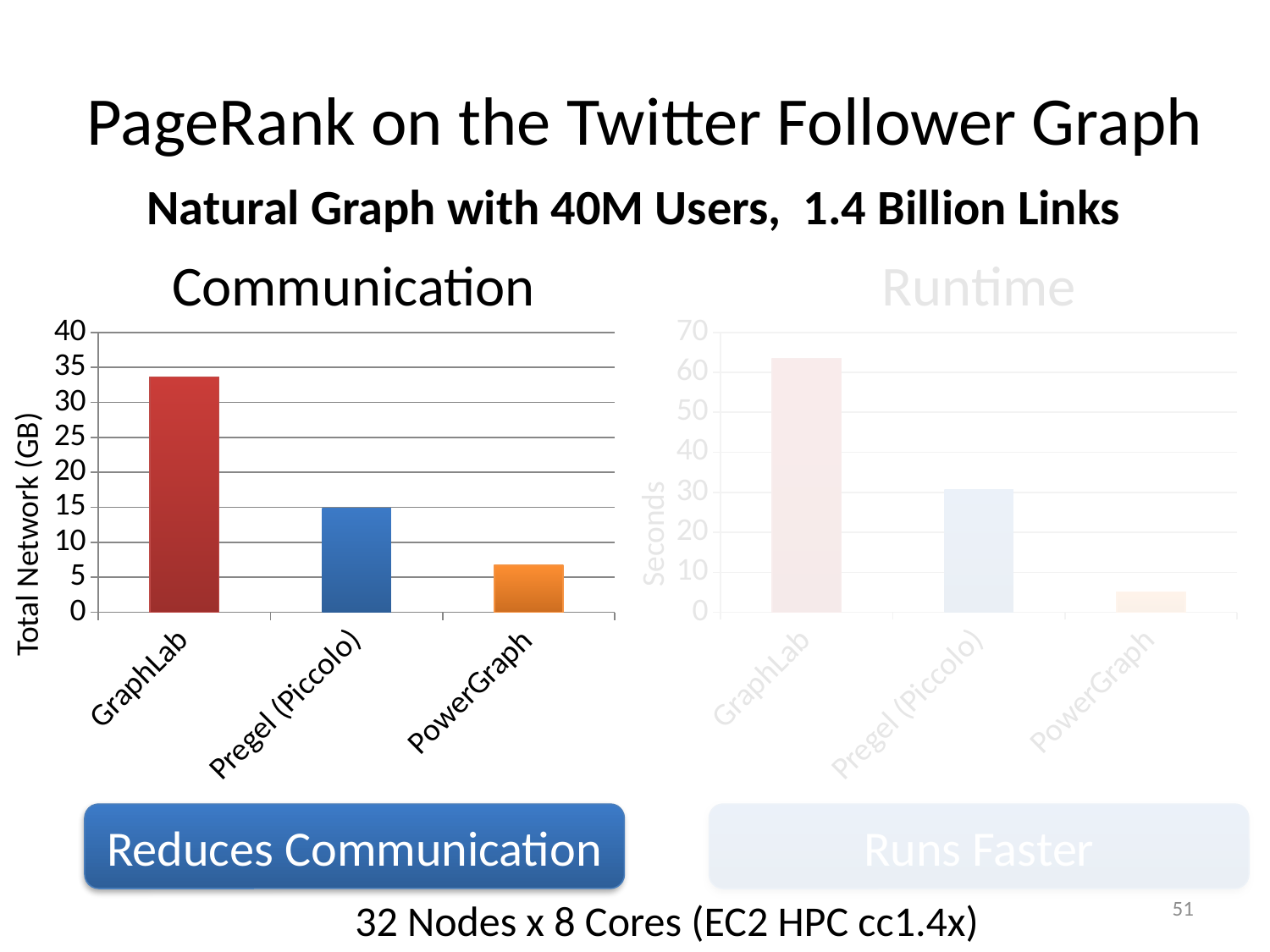
How many categories are shown in the Communication chart? 3 What is the y-axis label of the Communication chart? Total Network (GB) In the Communication chart, which category has the highest value? GraphLab In the Runtime chart, is the value for GraphLab greater or less than 60? greater What kind of chart is the Communication chart? bar chart In the Runtime chart, which category has the highest value? GraphLab In the Communication chart, is the value for GraphLab greater or less than 30? greater In the Communication chart, which is larger, the value for Pregel (Piccolo) or the value for PowerGraph? Pregel (Piccolo) In the Runtime chart, is the value for PowerGraph greater or less than 10? less In the Communication chart, which category has the lowest value? PowerGraph Do the values in the Communication chart rise or fall from left to right along the x axis? fall